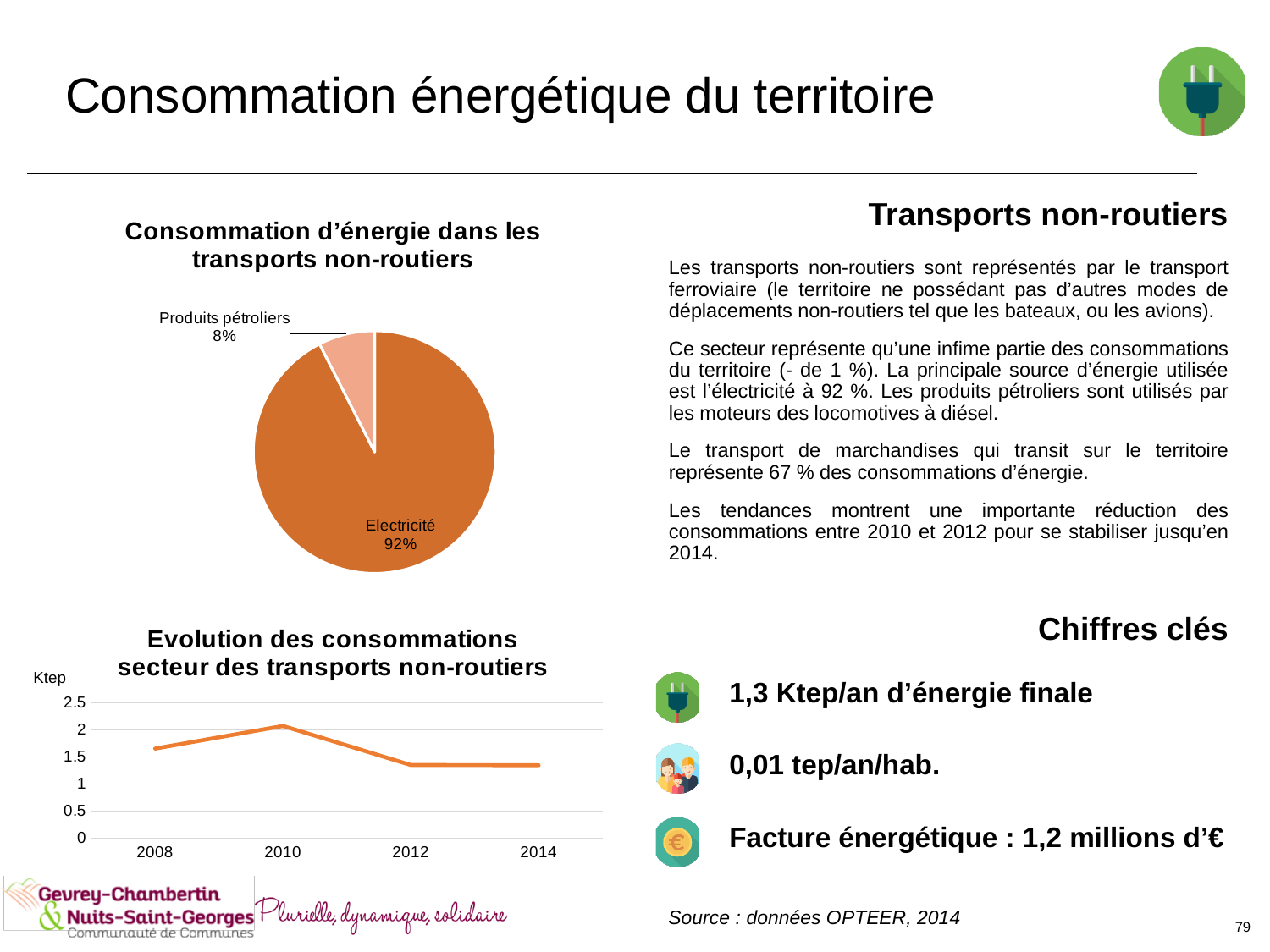
In the pie chart 'Consommation d'énergie dans les transports non-routiers', how many slices are there? 2 In the chart 'Evolution des consommations secteur des transports non-routiers', what unit is shown on the y axis? Ktep What type of chart is 'Evolution des consommations secteur des transports non-routiers'? Line chart In the pie chart 'Consommation d'énergie dans les transports non-routiers', what share is Electricité? 92% In the chart 'Evolution des consommations secteur des transports non-routiers', is the value for 2010 greater or less than 1.5? greater In the pie chart 'Consommation d'énergie dans les transports non-routiers', what is the difference in percentage points between Electricité and Produits pétroliers? 84 percentage points What type of chart is 'Consommation d'énergie dans les transports non-routiers'? Pie chart In the pie chart 'Consommation d'énergie dans les transports non-routiers', what share is Produits pétroliers? 8% In the chart 'Evolution des consommations secteur des transports non-routiers', is the value for 2012 greater or less than 1.5? less In the chart 'Evolution des consommations secteur des transports non-routiers', which year has the highest value? 2010 In the pie chart 'Consommation d'énergie dans les transports non-routiers', which category has the largest share? Electricité In the chart 'Evolution des consommations secteur des transports non-routiers', how many years are shown on the x axis? 4